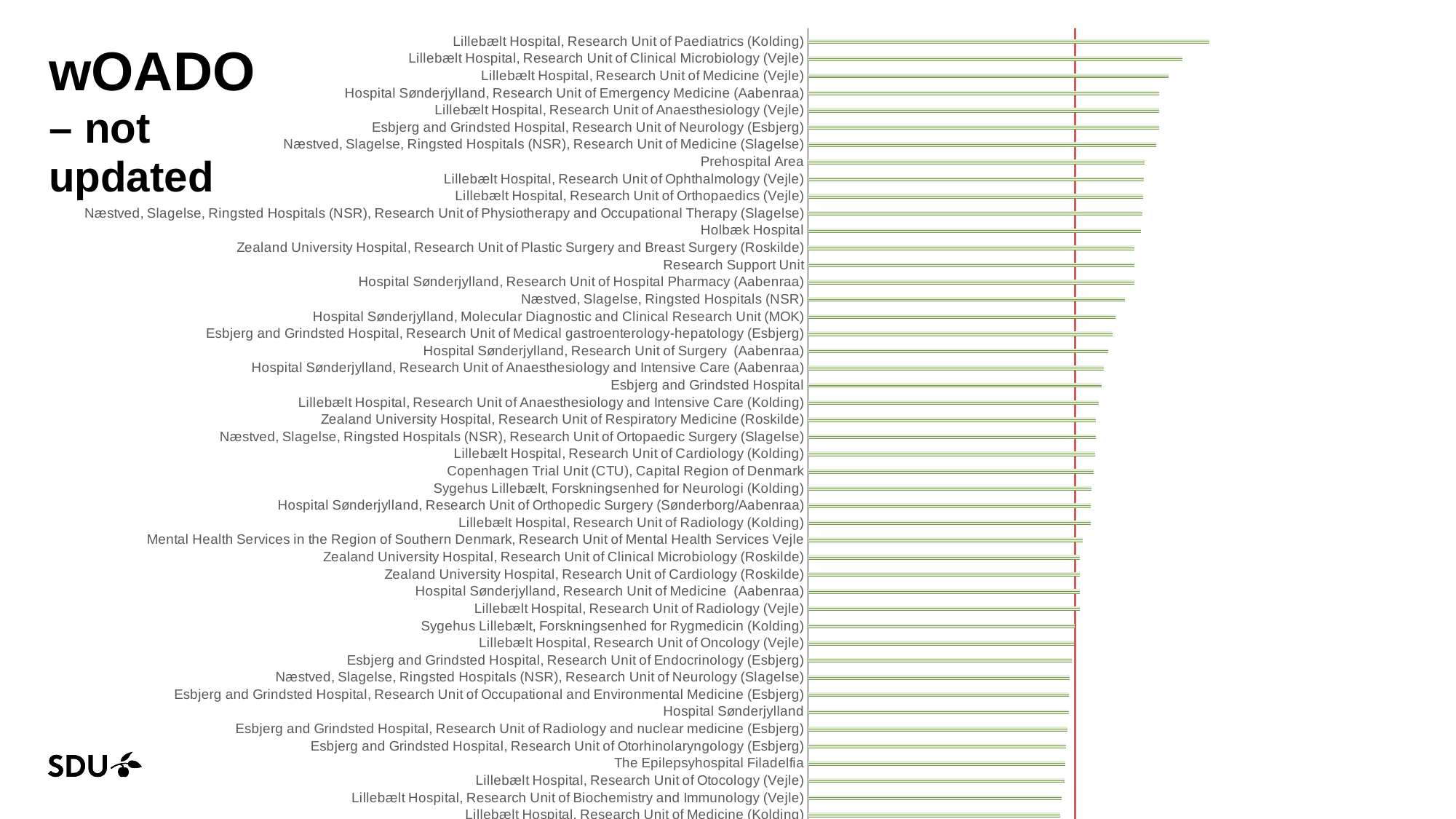
What is the title text shown on the slide? wOADO – not updated Which has the longer bar: Prehospital Area or Esbjerg and Grindsted Hospital? Prehospital Area Going from the top of the chart to the bottom, do the bar lengths increase or decrease? decrease Which has the longer bar: Lillebælt Hospital, Research Unit of Medicine (Vejle) or Copenhagen Trial Unit (CTU), Capital Region of Denmark? Lillebælt Hospital, Research Unit of Medicine (Vejle) Which category has the second-longest bar in the chart? Lillebælt Hospital, Research Unit of Clinical Microbiology (Vejle) Which has the longer bar: Lillebælt Hospital, Research Unit of Paediatrics (Kolding) or Hospital Sønderjylland? Lillebælt Hospital, Research Unit of Paediatrics (Kolding) What kind of chart is shown on the slide? bar chart Is the bar for Lillebælt Hospital, Research Unit of Paediatrics (Kolding) to the left or to the right of the red vertical line? right Which category has the longest bar in the chart? Lillebælt Hospital, Research Unit of Paediatrics (Kolding)